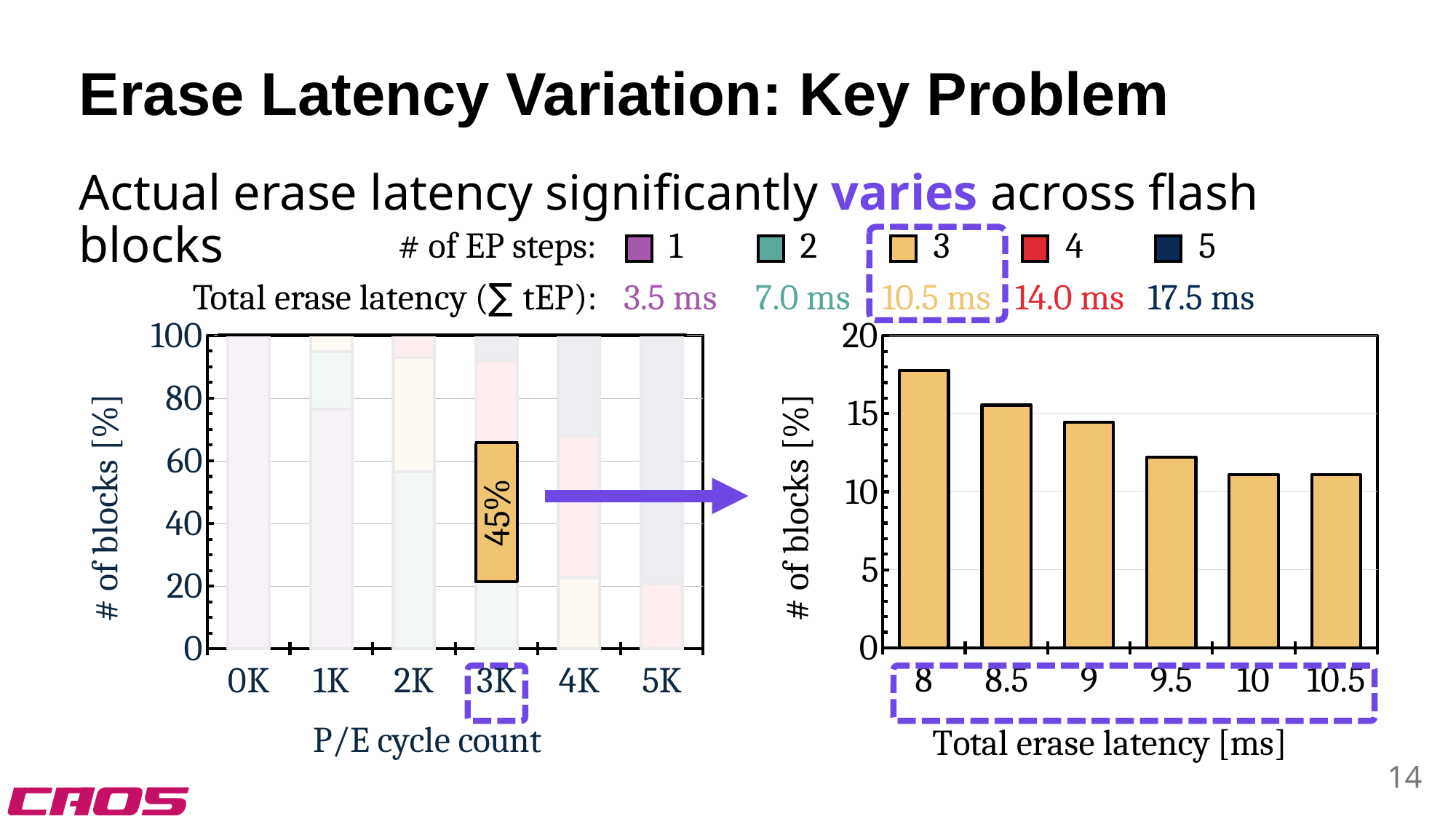
In the left chart (# of blocks vs P/E cycle count), what percentage is printed on the highlighted segment at 3K? 45% In the left chart, how many P/E cycle count categories are shown on the x axis? 6 In the right chart (# of blocks vs Total erase latency), which total erase latency has the highest percentage of blocks? 8 In the right chart, is the value for 8 ms greater or less than 15? greater How many series (# of EP steps) does the legend list? 5 In the right chart, which has a larger value: 8.5 ms or 9.5 ms? 8.5 ms In the right chart, is the value for 10 ms greater or less than 10? greater According to the legend, what is the total erase latency for 3 EP steps? 10.5 ms In the right chart, how many bars are plotted? 6 What kind of chart is the left chart (# of blocks vs P/E cycle count)? Stacked bar chart In the right chart, is the value for 9.5 ms greater or less than 15? less In the right chart, do the values rise or fall as total erase latency increases from 8 to 10.5 ms? Fall